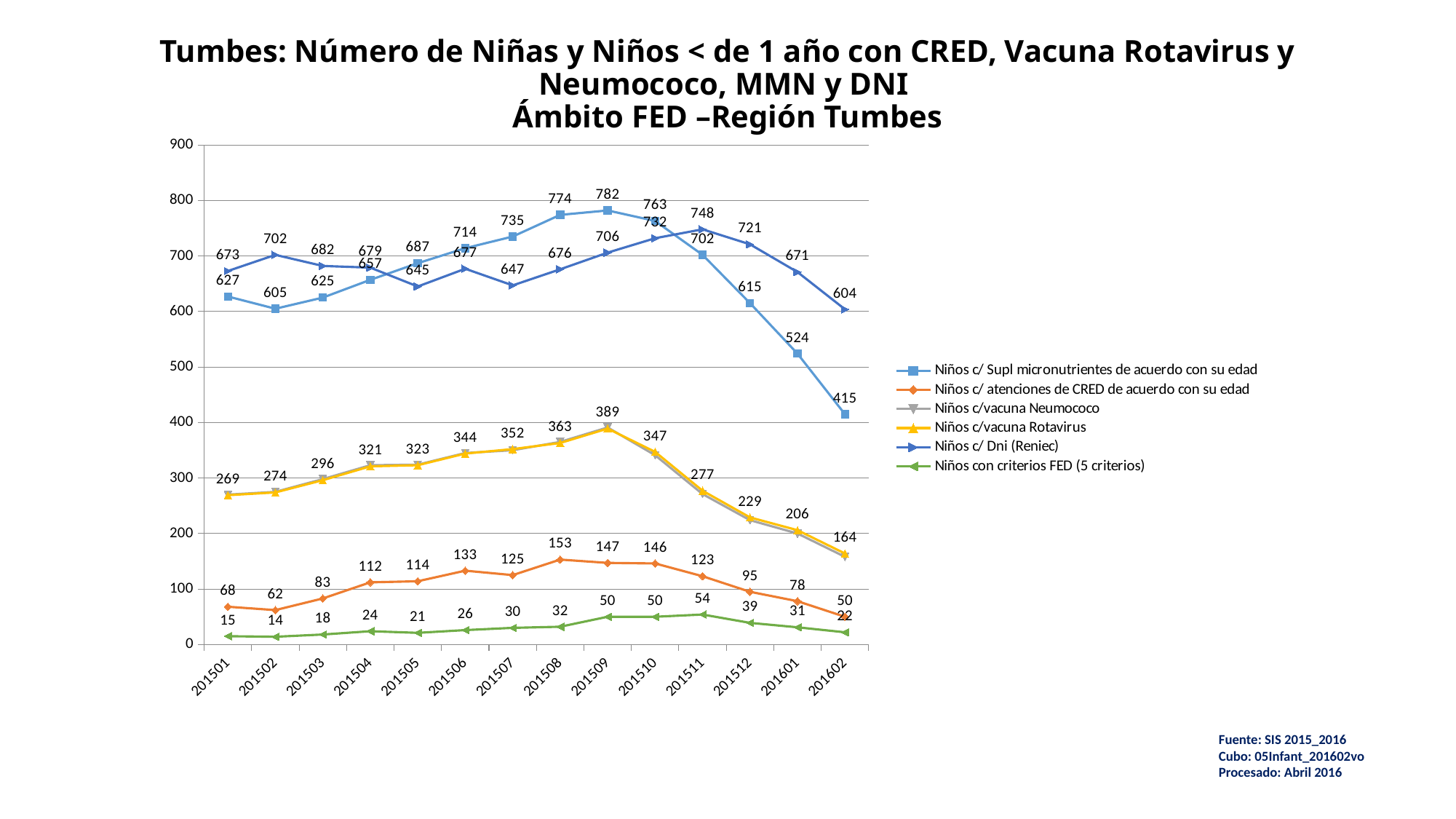
In which month does 'Niños c/ Supl micronutrientes de acuerdo con su edad' reach its highest value? 201509 Does 'Niños c/ Supl micronutrientes de acuerdo con su edad' rise or fall from 201511 to 201602? fall How many months (x-axis categories) are plotted on the chart? 14 What kind of chart is shown on the slide? line chart What is the difference between the 'Niños c/ Supl micronutrientes de acuerdo con su edad' values in 201501 and 201602? 212 What is the value for 'Niños c/ Dni (Reniec)' in 201511? 748 What is the value for 'Niños c/ Supl micronutrientes de acuerdo con su edad' in 201509? 782 Is the value for 'Niños c/vacuna Neumococo' in 201509 greater or less than 300? greater How many series does the legend list? 6 In which month is 'Niños con criterios FED (5 criterios)' at its lowest value? 201502 What is the value for 'Niños c/ atenciones de CRED de acuerdo con su edad' in 201508? 153 In 201602, which is larger: 'Niños c/ Dni (Reniec)' or 'Niños c/ Supl micronutrientes de acuerdo con su edad'? Niños c/ Dni (Reniec)